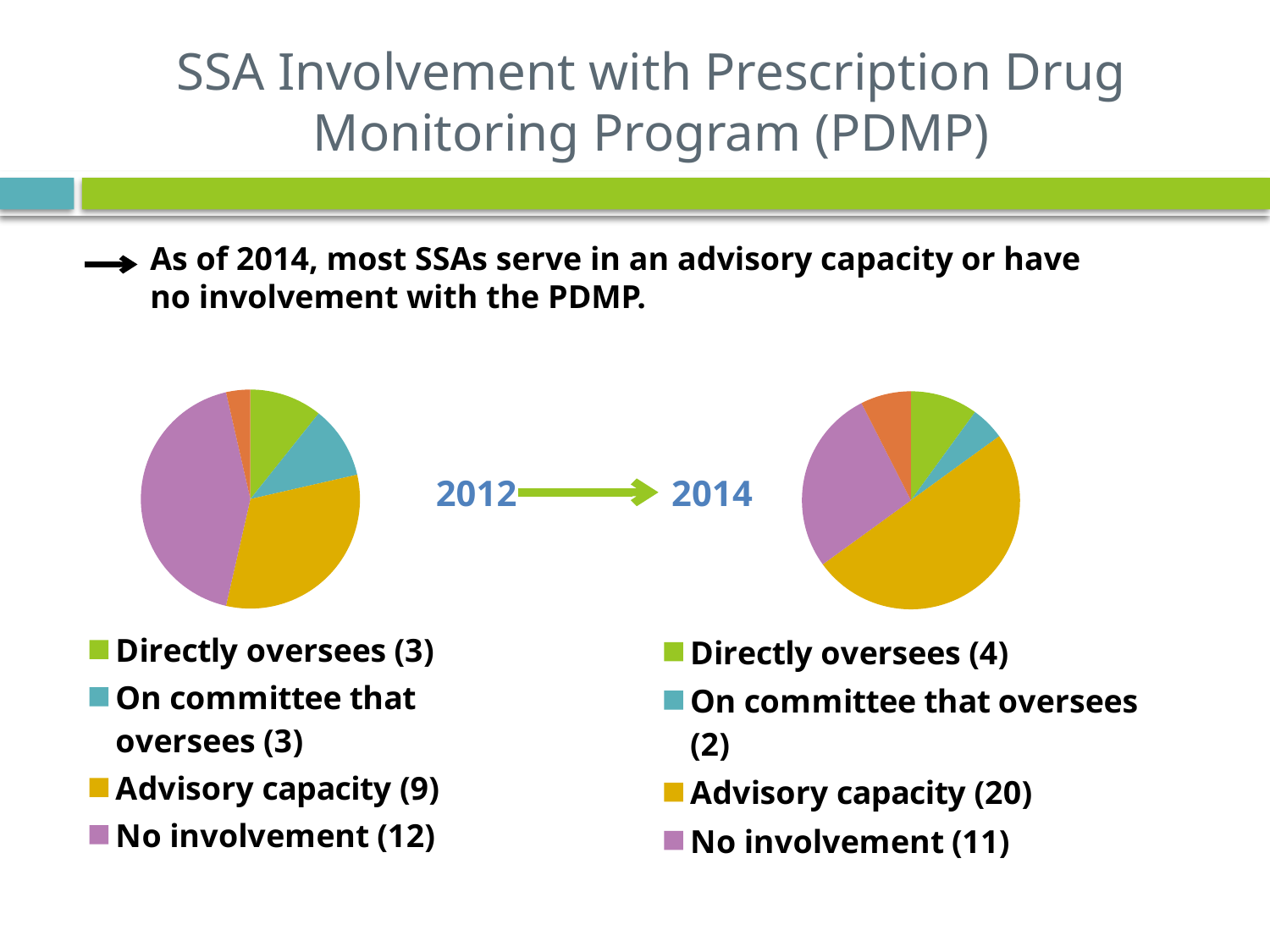
In the 2014 pie chart (right), what is the value for On committee that oversees? 2 In the 2012 pie chart (left), what is the value for Advisory capacity? 9 In the 2014 pie chart (right), what is the value for Advisory capacity? 20 In the 2014 pie chart (right), which legend category has the lowest value? On committee that oversees How much larger is the Advisory capacity value in the 2014 pie chart than in the 2012 pie chart? 11 In the 2014 pie chart (right), what is the difference between Advisory capacity and No involvement? 9 In the 2014 pie chart (right), which legend category has the highest value? Advisory capacity How many entries does the legend of the 2014 pie chart (right) list? 4 In the 2012 pie chart (left), which is larger: Advisory capacity or No involvement? No involvement What kind of chart is used on this slide for 2012 and 2014? Pie chart In the 2012 pie chart (left), which legend category has the highest value? No involvement In the 2012 pie chart (left), what is the value for No involvement? 12